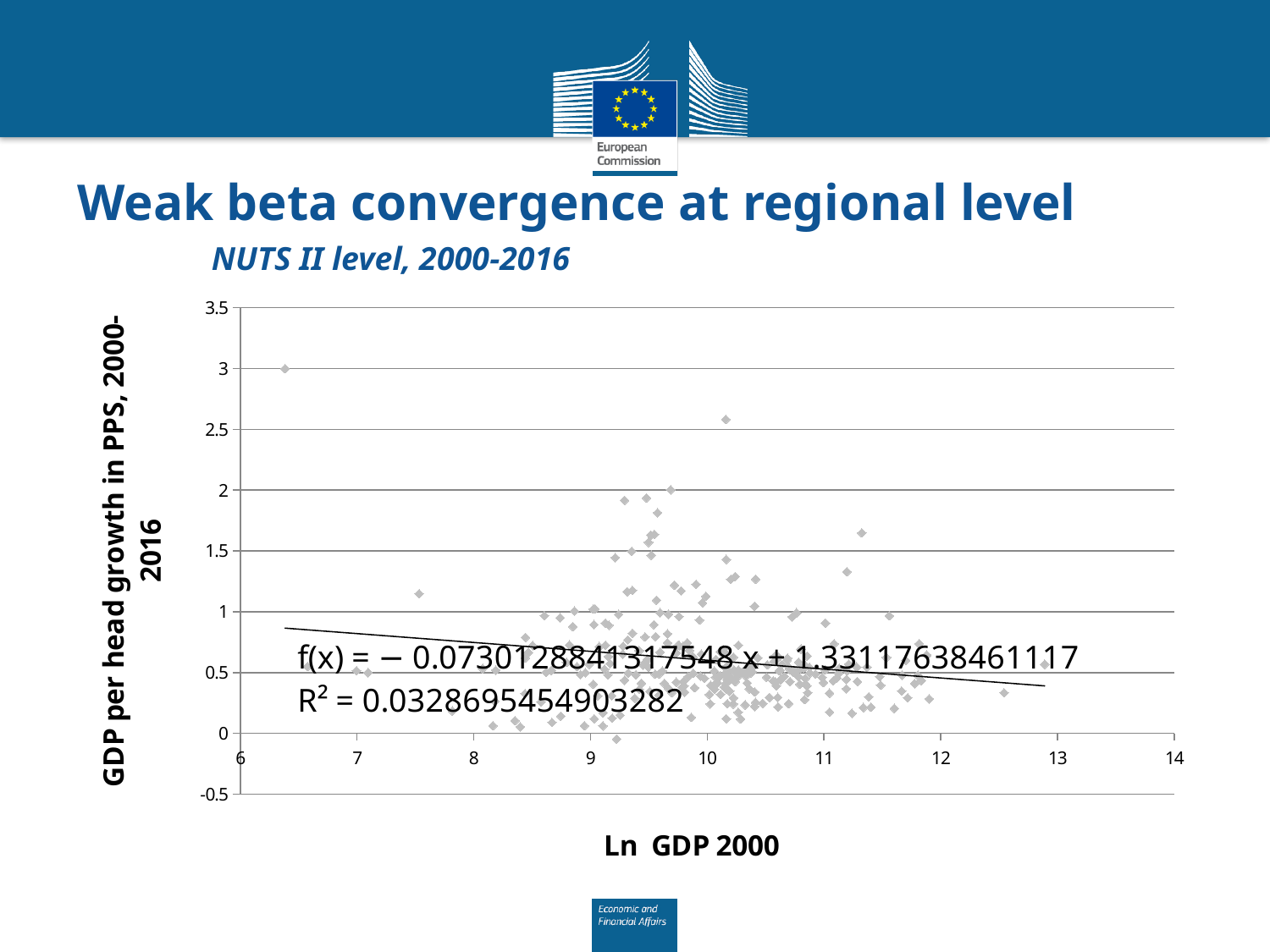
What is the lowest value shown on the y axis? -0.5 What is the R² value printed on the chart? 0.0328695454903282 Is the slope of the fitted line f(x) positive or negative? negative What is the label of the x axis? Ln GDP 2000 Is the value of the fitted line at Ln GDP 2000 = 7 greater or less than 0.5? greater According to the fitted trend line, do values of GDP per head growth rise or fall as Ln GDP 2000 increases? fall Is the highest plotted point on the chart greater or less than 2.5 on the y axis? greater What kind of chart is shown on the slide? scatter plot Is the value of the fitted line at Ln GDP 2000 = 13 greater or less than 0.5? less What is the highest value shown on the x axis? 14